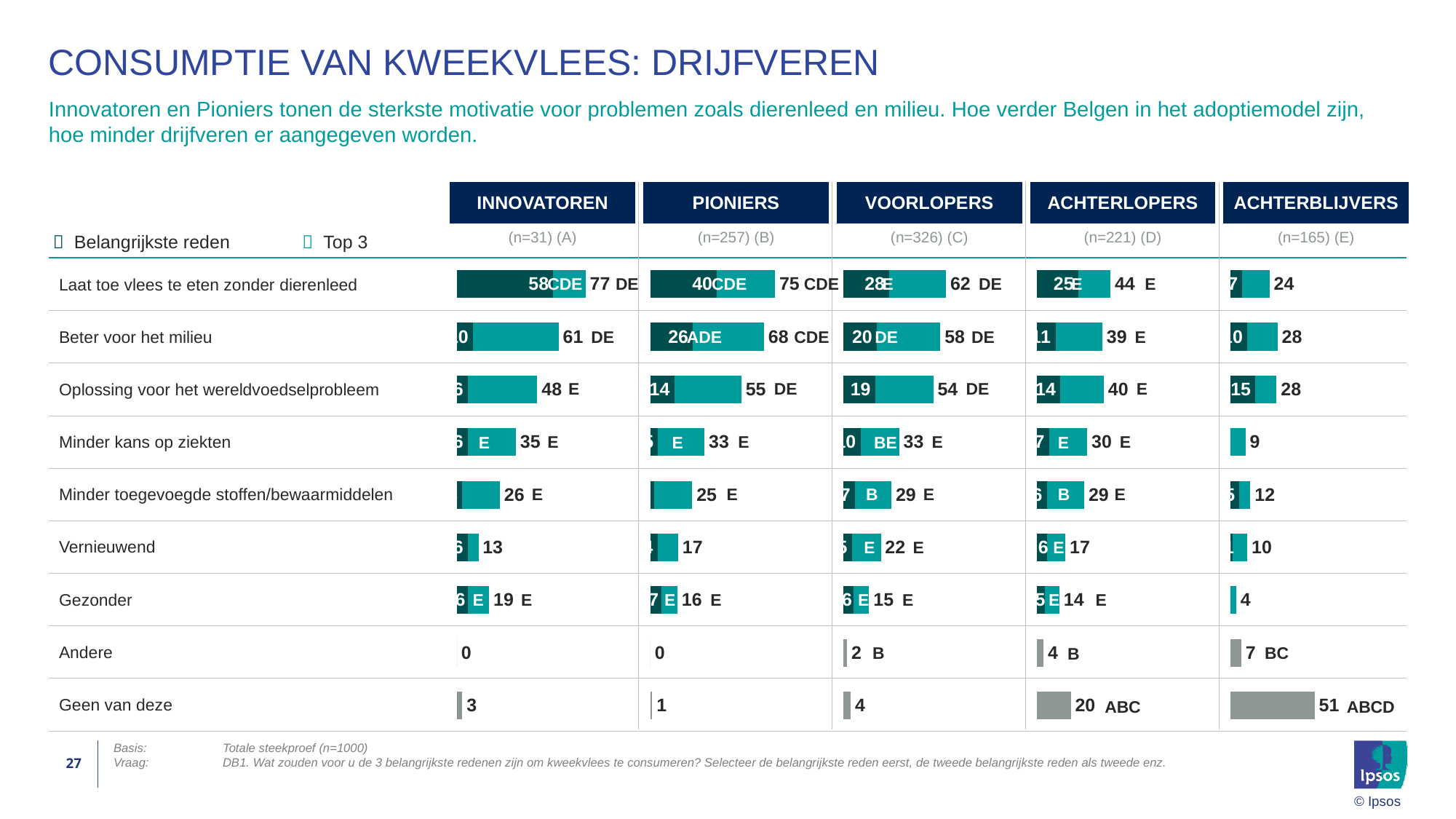
In the Achterblijvers column, which reason has the lowest Top 3 value? Gezonder What kind of chart is used to display the values in the table? Bar chart How many reasons (rows) are listed in the chart? 9 What is the sample size (n) for the Voorlopers segment? 326 In the Achterblijvers column, what is the Top 3 value for 'Geen van deze'? 51 In the Voorlopers column, what is the Top 3 value for 'Oplossing voor het wereldvoedselprobleem'? 54 In the Innovatoren column, what is the Top 3 value for 'Laat toe vlees te eten zonder dierenleed'? 77 Which is larger: the Top 3 value for 'Minder kans op ziekten' among Innovatoren or among Pioniers? Innovatoren In the Pioniers column, what is the Top 3 value for 'Beter voor het milieu'? 68 How many respondent segments (columns) are shown in the chart? 5 What is the difference between the Top 3 values for 'Laat toe vlees te eten zonder dierenleed' in the Innovatoren column and the Achterblijvers column? 53 In the Achterlopers column, which reason has the highest Top 3 value? Laat toe vlees te eten zonder dierenleed